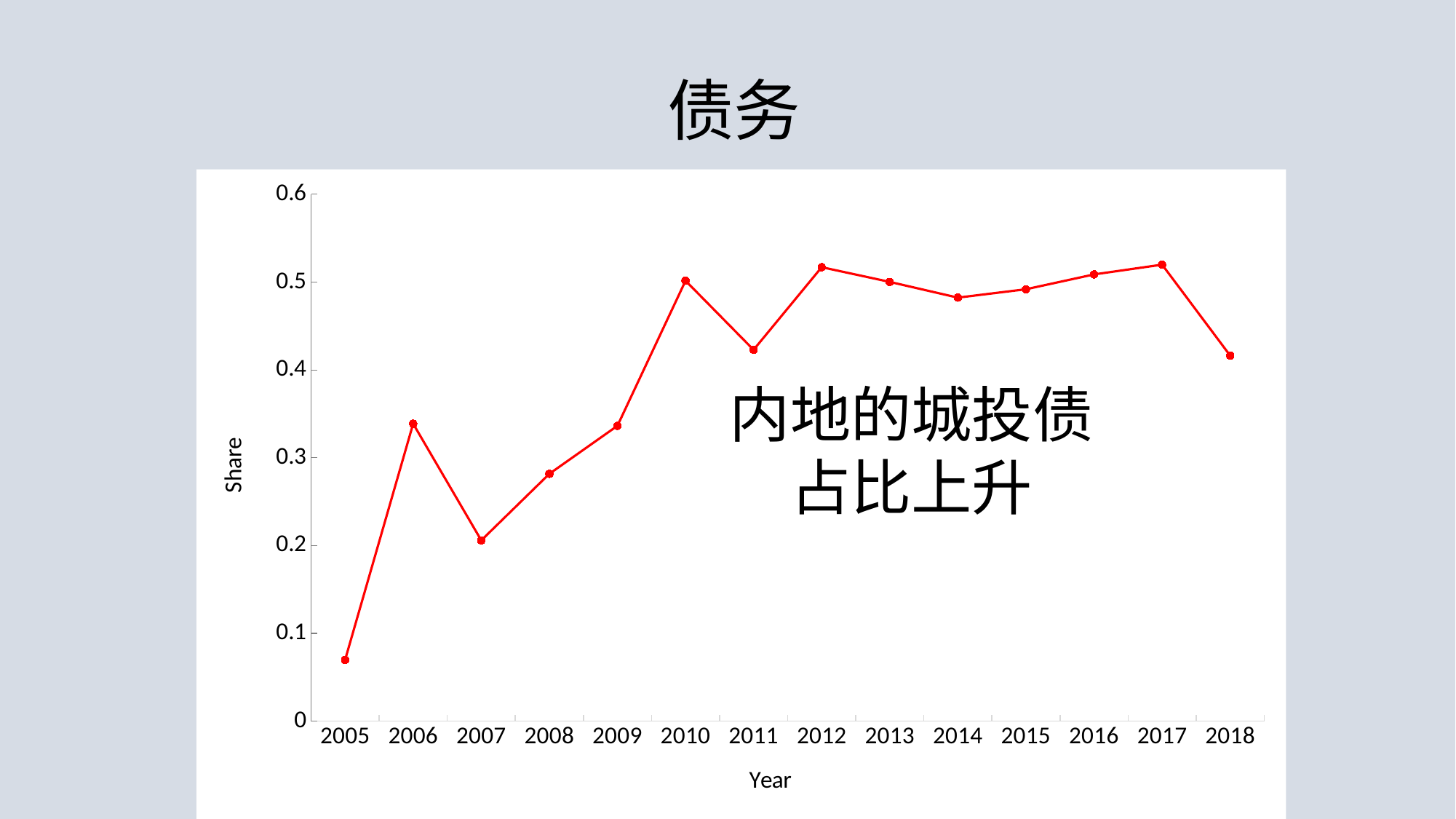
Is the value for 2014 greater or less than 0.5? less What is the label on the y axis? Share Is the value for 2008 greater or less than 0.3? less Which year has the larger share, 2006 or 2007? 2006 What kind of chart is shown on the slide? line chart Is the value for 2005 greater or less than 0.1? less Which year has the lowest share? 2005 What colour is the plotted line? red Does the share rise or fall from 2017 to 2018? fall Which year has the larger share, 2017 or 2018? 2017 How many years are plotted along the x axis? 14